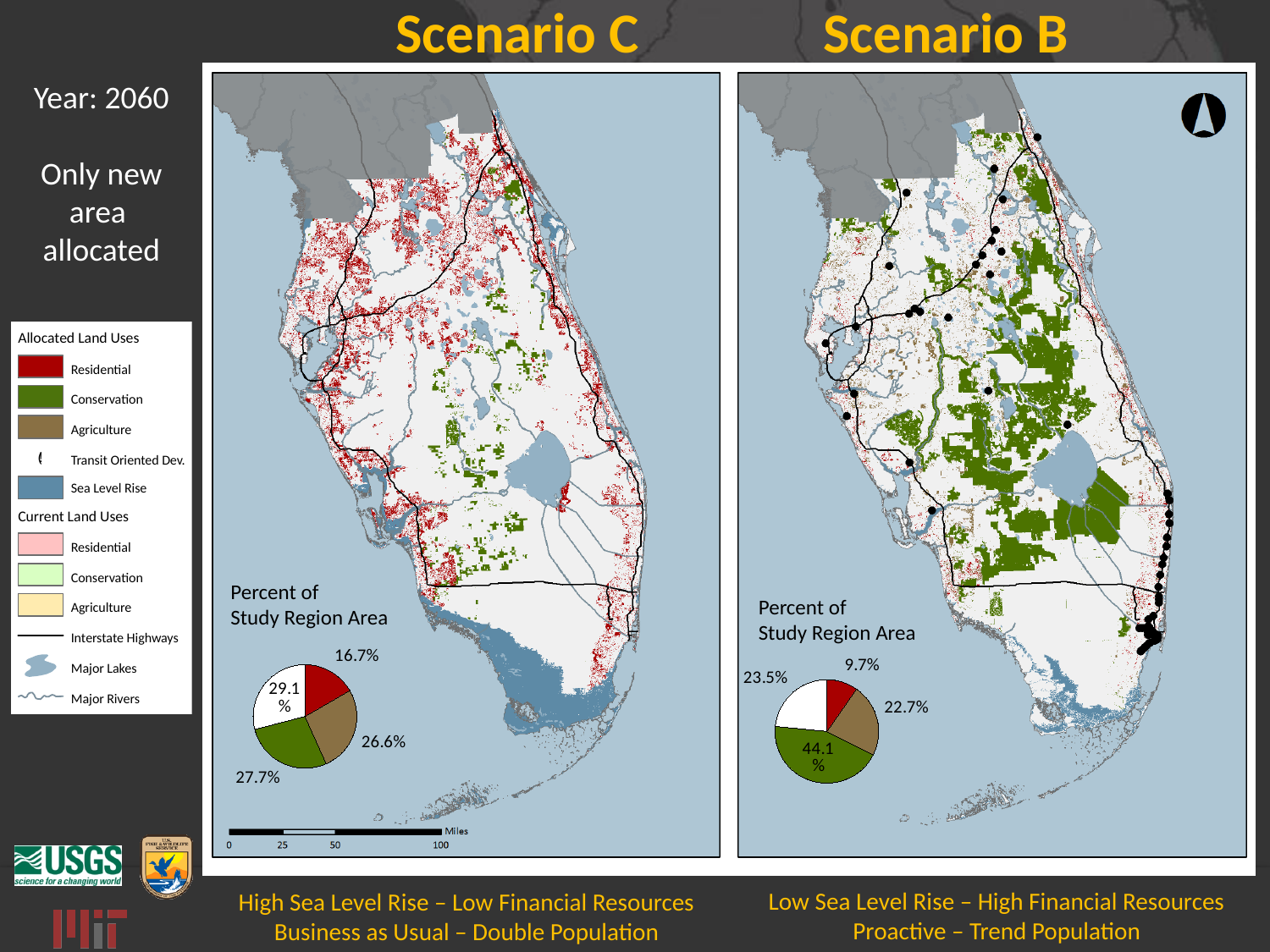
In the Scenario C pie chart, what is the difference between the 27.7% slice and the 26.6% slice? 1.1 percentage points What kind of chart is shown under "Percent of Study Region Area" on the Scenario C map? Pie chart In the Scenario B pie chart, what percentage is shown for the green (Conservation) slice? 44.1% In the Scenario B pie chart, what percentage is shown for the brown (Agriculture) slice? 22.7% How many slices does the Scenario C pie chart have? 4 In the Scenario B pie chart, what is the difference between the 44.1% slice and the 22.7% slice? 21.4 percentage points In the Scenario C pie chart, what is the value of the largest slice? 29.1% In the Scenario C pie chart, what is the value of the smallest slice? 16.7% Is the red (Residential) slice larger in the Scenario C pie chart or the Scenario B pie chart? Scenario C In the Scenario C pie chart, what percentage is shown for the red (Residential) slice? 16.7% In the Scenario B pie chart, what is the value of the smallest slice? 9.7% In the Scenario B pie chart, what is the value of the largest slice? 44.1%